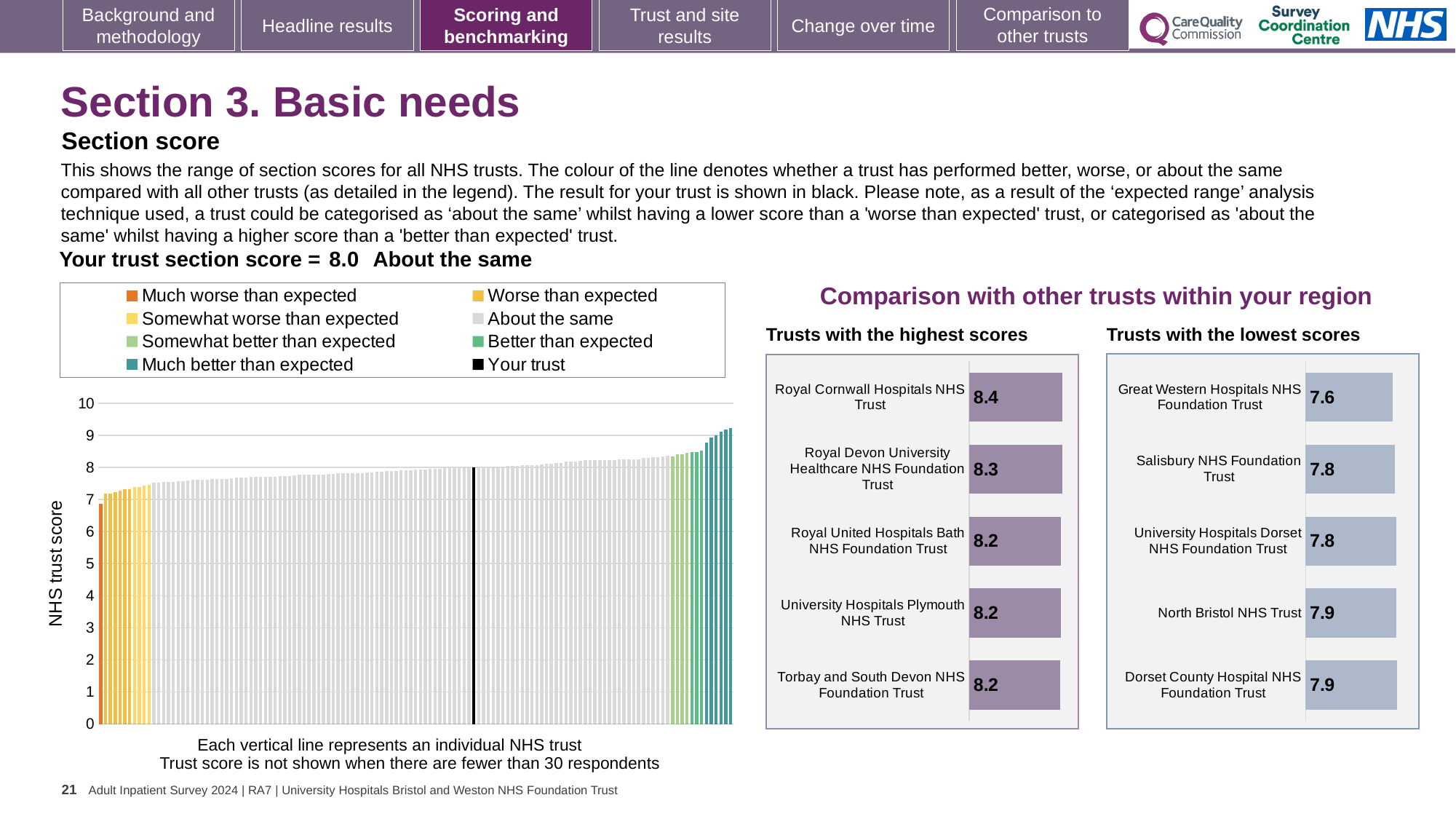
In the left-hand NHS trust score chart, is the value of the black 'Your trust' bar greater or less than 5? greater In the left-hand NHS trust score chart, do the bar values rise or fall from left to right? rise In the 'Trusts with the highest scores' chart, what is the score for Royal Cornwall Hospitals NHS Trust? 8.4 In the 'Trusts with the lowest scores' chart, which has the larger score: Salisbury NHS Foundation Trust or North Bristol NHS Trust? North Bristol NHS Trust How many entries does the legend of the left-hand NHS trust score chart list? 8 In the 'Trusts with the lowest scores' chart, which trust has the lowest score? Great Western Hospitals NHS Foundation Trust In the 'Trusts with the lowest scores' chart, what is the score for Great Western Hospitals NHS Foundation Trust? 7.6 What kind of chart is the large chart on the left showing NHS trust scores? Bar chart In the 'Trusts with the highest scores' chart, what is the difference between the scores of Royal Cornwall Hospitals NHS Trust and Torbay and South Devon NHS Foundation Trust? 0.2 In the 'Trusts with the highest scores' chart, which trust has the highest score? Royal Cornwall Hospitals NHS Trust What is the section score for your trust shown above the left-hand chart? 8.0 How many trusts are listed in the 'Trusts with the highest scores' chart? 5